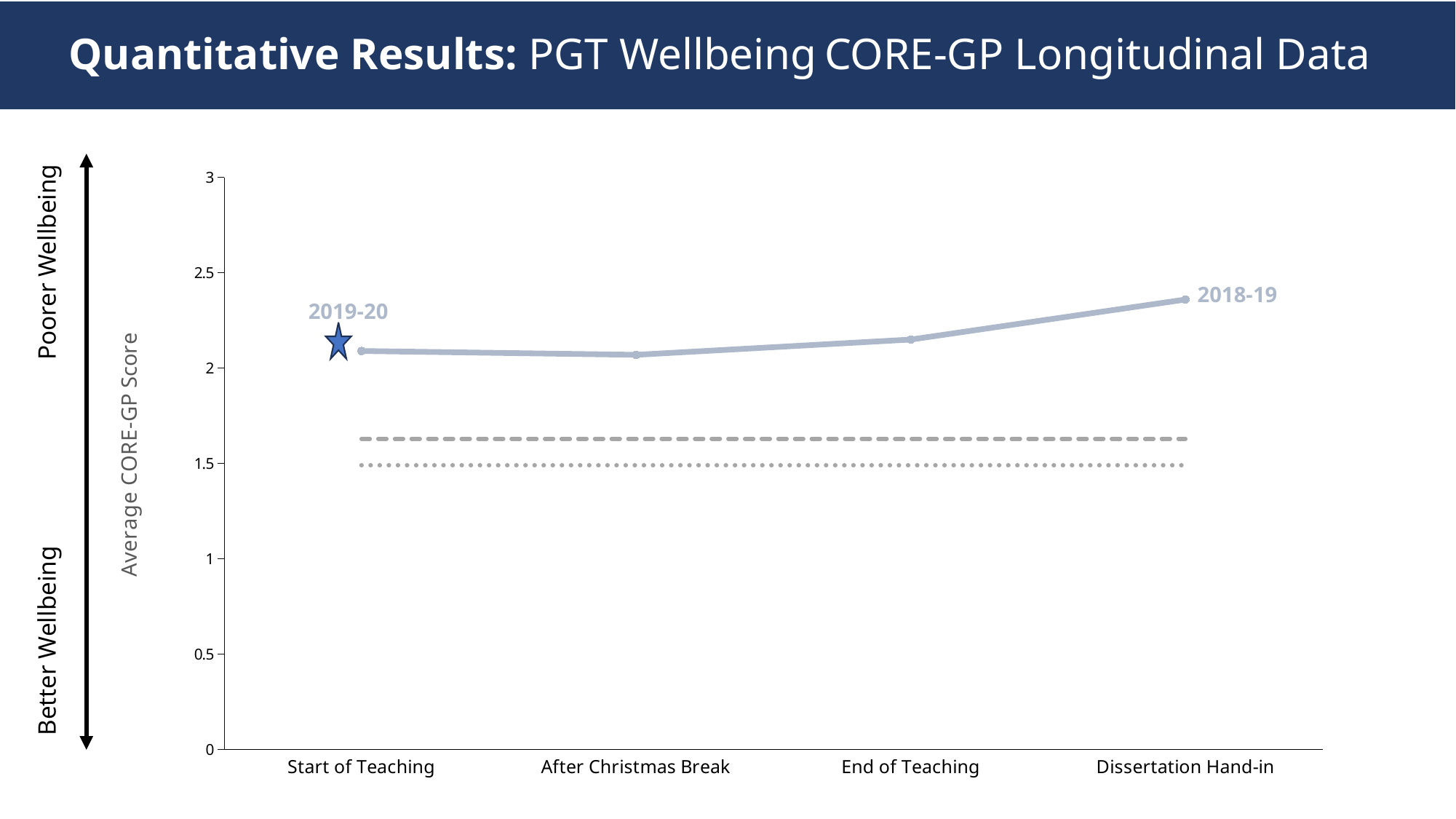
How many time points are shown along the x axis of the chart? 4 What is the title of the y axis of the chart? Average CORE-GP Score At which time point is the 2018-19 average CORE-GP score highest? Dissertation Hand-in Is the 2018-19 value at After Christmas Break greater or less than 2.5? less Is the 2018-19 value at End of Teaching greater or less than 2? greater What kind of chart is shown on the slide? line chart Is the dashed horizontal reference line greater or less than 2? less Which academic year is labelled at the right-hand end of the plotted line? 2018-19 Does the 2018-19 average CORE-GP score rise or fall from Start of Teaching to Dissertation Hand-in? rise Which is larger for 2018-19: the value at Dissertation Hand-in or the value at Start of Teaching? Dissertation Hand-in